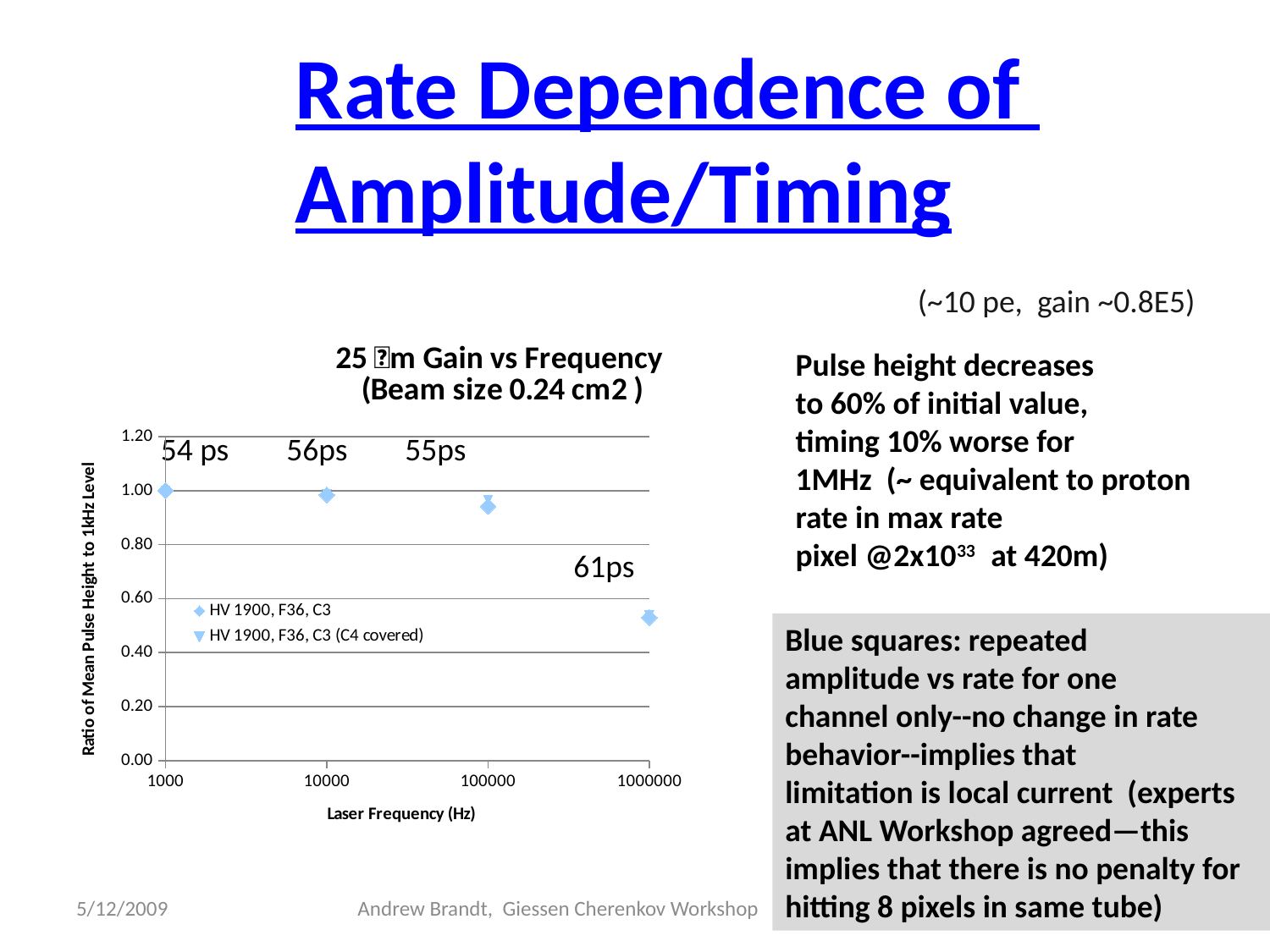
What timing value is annotated on the chart for the 1000000 Hz point? 61ps What is the title of the chart's x axis? Laser Frequency (Hz) Is the pulse height ratio at 1000000 Hz greater or less than 0.60? less What kind of chart is shown on the slide? scatter chart Which has the larger pulse height ratio: 10000 Hz or 1000000 Hz? 10000 Hz At which laser frequency is the pulse height ratio lowest? 1000000 Hz How many series does the chart legend list? 2 At which laser frequency is the pulse height ratio highest? 1000 Hz What is the pulse height ratio at 1000 Hz? 1.00 How many laser frequency values have data points plotted on the chart? 4 Is the pulse height ratio at 100000 Hz greater or less than 0.80? greater Does the ratio of mean pulse height rise or fall as laser frequency increases? fall